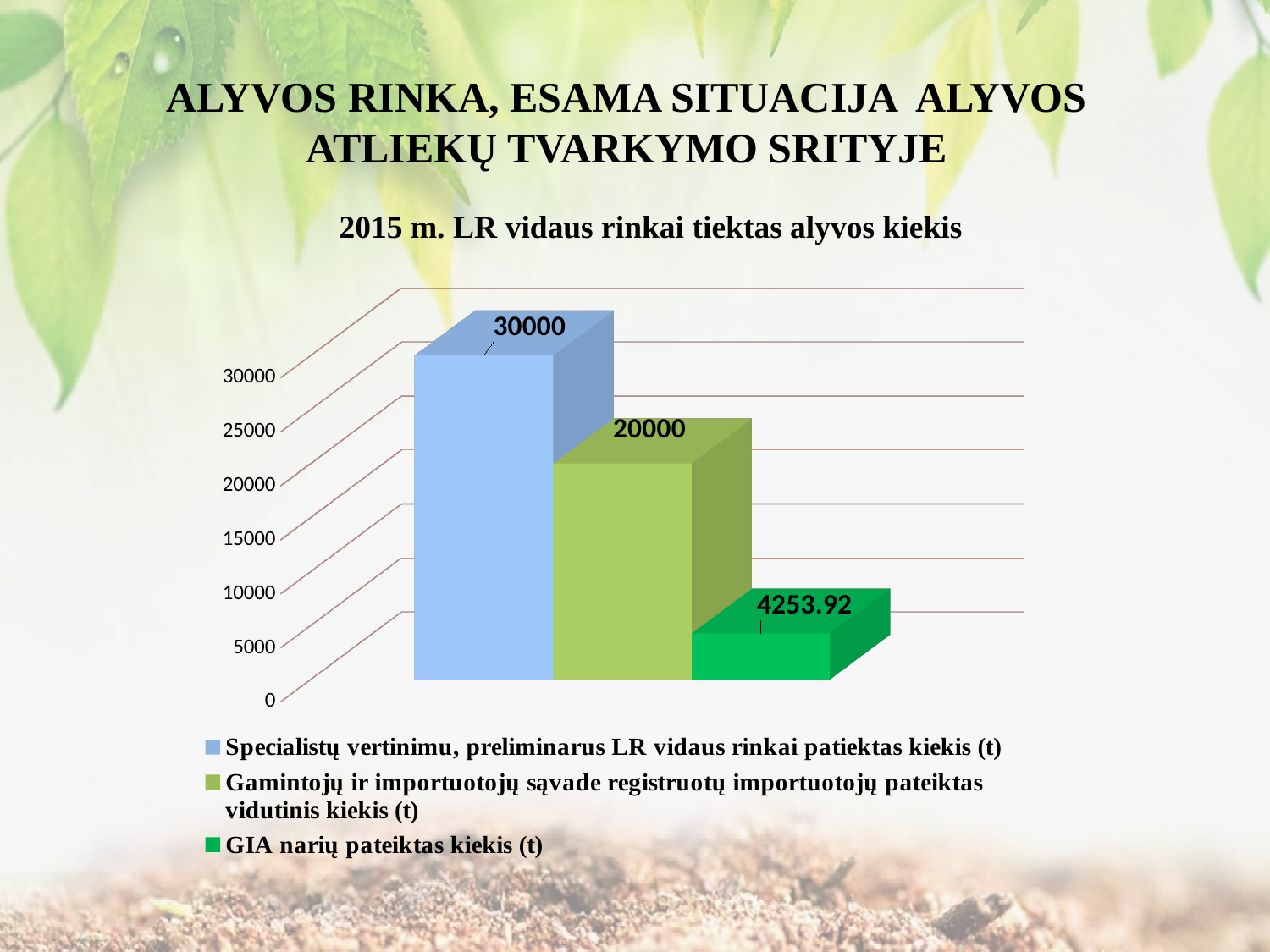
What is the value for 'GIA narių pateiktas kiekis (t)'? 4253.92 Which series has the highest value? Specialistų vertinimu, preliminarus LR vidaus rinkai patiektas kiekis (t) What is the difference between the 'Gamintojų ir importuotojų sąvade' value and the 'GIA narių pateiktas kiekis (t)' value? 15746.08 What is the title of the chart? 2015 m. LR vidaus rinkai tiektas alyvos kiekis Which is larger: the 'Gamintojų ir importuotojų sąvade' value or the 'GIA narių pateiktas kiekis (t)' value? Gamintojų ir importuotojų sąvade registruotų importuotojų pateiktas vidutinis kiekis (t) Which series has the lowest value? GIA narių pateiktas kiekis (t) What is the value for 'Gamintojų ir importuotojų sąvade registruotų importuotojų pateiktas vidutinis kiekis (t)'? 20000 Is the value for 'GIA narių pateiktas kiekis (t)' greater or less than 5000? less How many series does the legend list? 3 What is the difference between the 'Specialistų vertinimu' value and the 'Gamintojų ir importuotojų sąvade' value? 10000 What kind of chart is shown on the slide? bar chart What is the value for 'Specialistų vertinimu, preliminarus LR vidaus rinkai patiektas kiekis (t)'? 30000